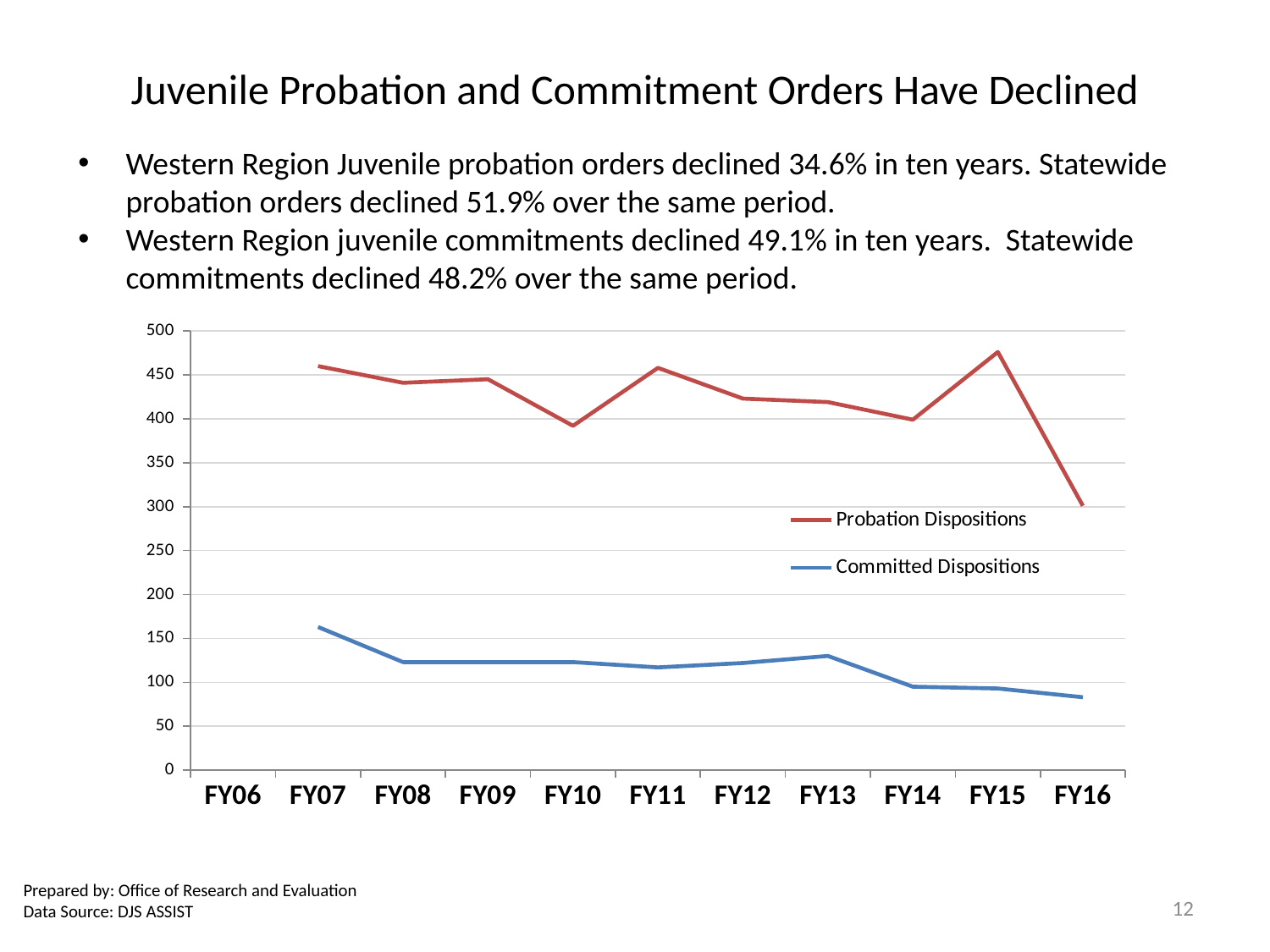
What kind of chart is shown on the slide? line chart Which series has the larger value in FY13, Probation Dispositions or Committed Dispositions? Probation Dispositions In which fiscal year does the Probation Dispositions line reach its highest value? FY15 Is the value for Probation Dispositions in FY16 greater or less than 350? less In which fiscal year does the Probation Dispositions line reach its lowest value? FY16 Is the value for Probation Dispositions in FY15 greater or less than 450? greater In which fiscal year does the Committed Dispositions line reach its highest value? FY07 How many series does the chart's legend list? 2 Is the value for Committed Dispositions in FY07 greater or less than 150? greater How many fiscal years are labeled on the x axis of the chart? 11 What colour is the Probation Dispositions line in the chart? red